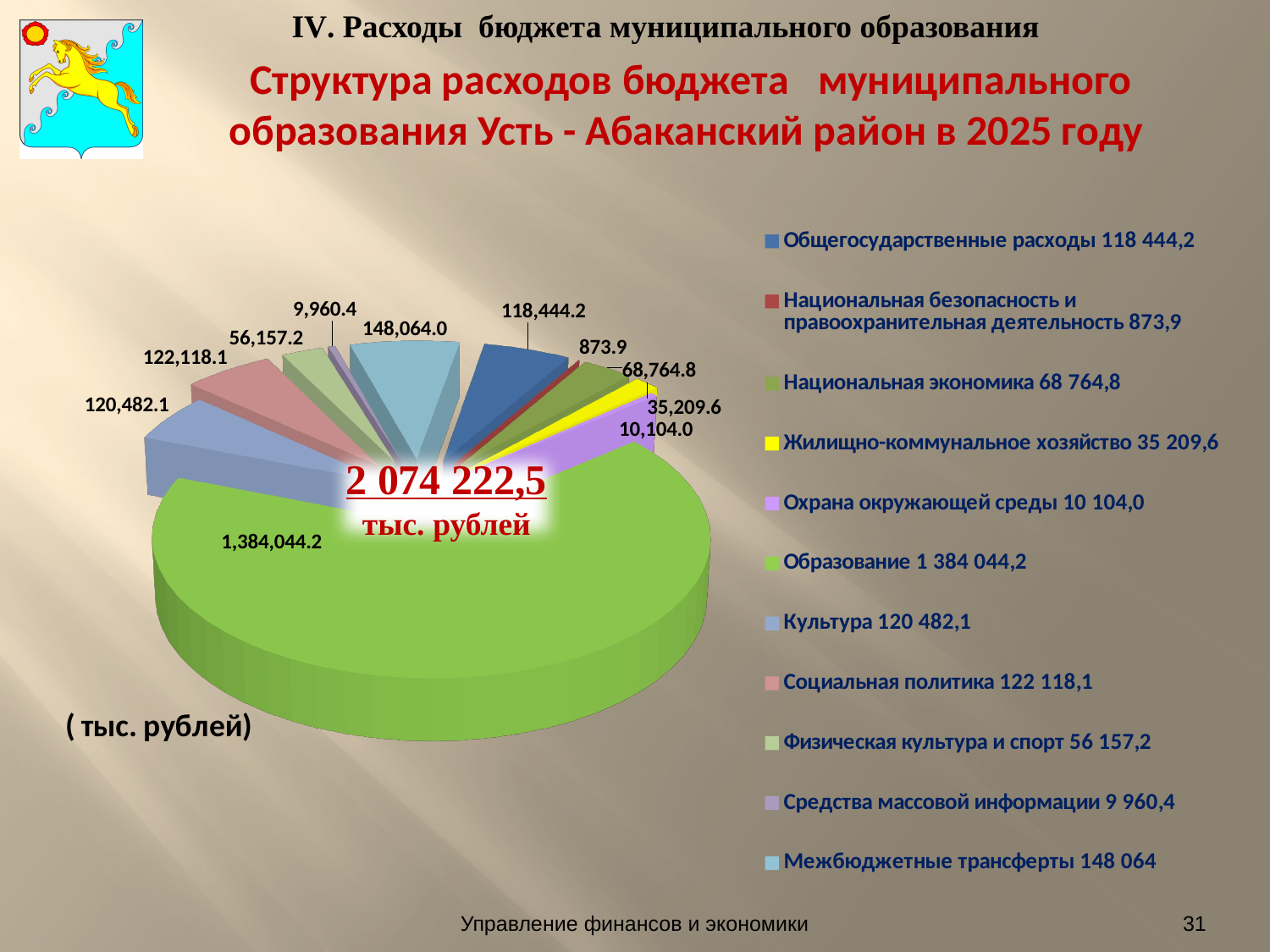
What type of chart is shown on the slide? pie chart How many slices (categories) does the pie chart have? 11 What is the value shown for Жилищно-коммунальное хозяйство? 35,209.6 What total amount is printed in the centre of the pie chart? 2 074 222,5 тыс. рублей Which category has the smallest slice in the pie chart? Национальная безопасность и правоохранительная деятельность What is the difference between Социальная политика (122,118.1) and Культура (120,482.1)? 1,636.0 What is the value shown for Образование? 1,384,044.2 What is the value shown for Межбюджетные трансферты? 148,064.0 Which category has the largest slice in the pie chart? Образование Which is larger: Культура or Социальная политика? Социальная политика What is the difference between Межбюджетные трансферты (148,064.0) and Общегосударственные расходы (118,444.2)? 29,619.8 What share of the total (2 074 222,5) does Образование (1,384,044.2) represent, to one decimal place? 66.7%